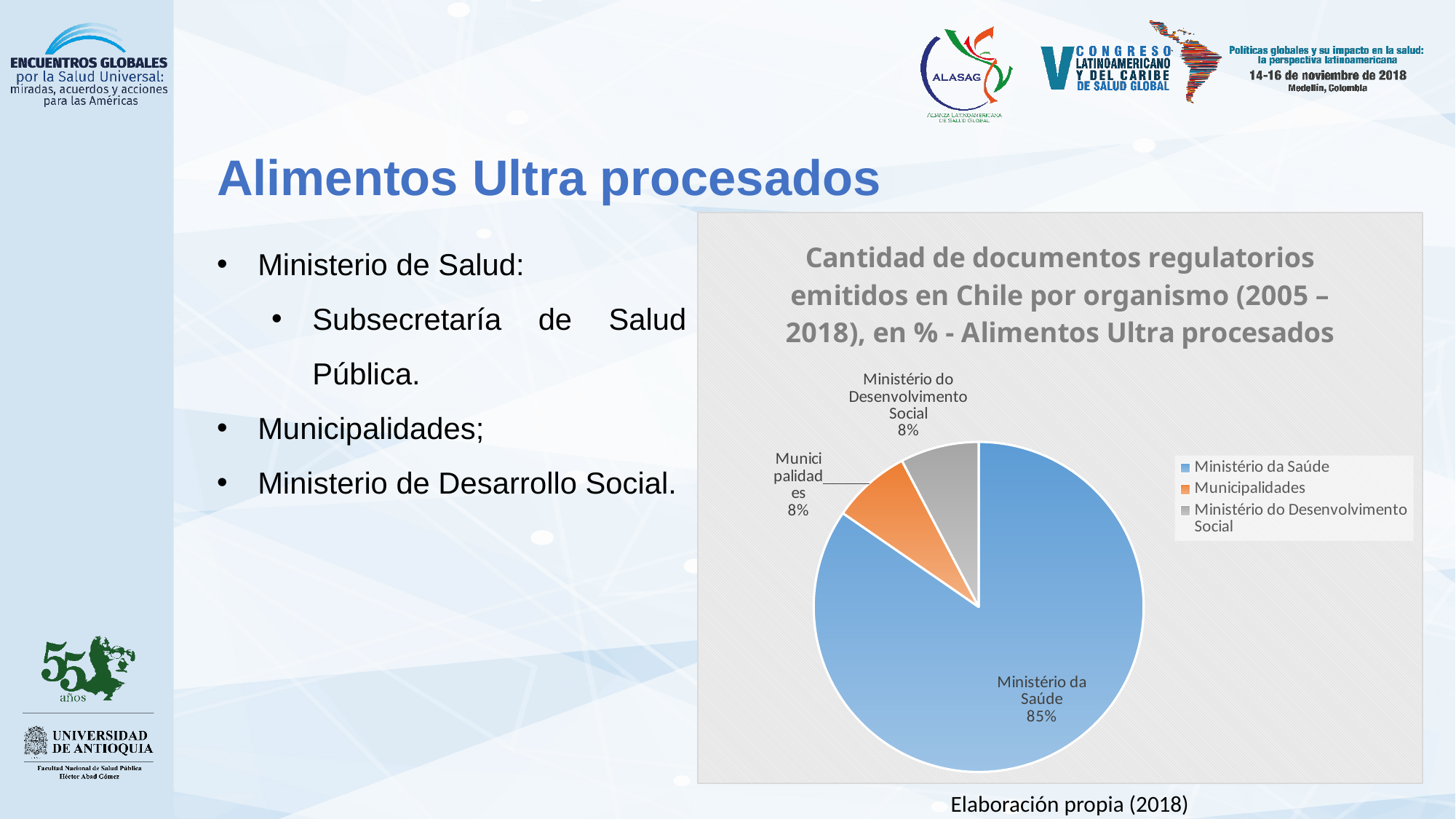
What colour is the Municipalidades slice in the pie chart? Orange What share of the pie does Ministério da Saúde have? 85% What is the difference in percentage points between the Ministério da Saúde slice and the Municipalidades slice? 77 What share of the pie does Municipalidades have? 8% What kind of chart is shown on the slide? Pie chart Which category has the largest slice of the pie? Ministério da Saúde What share of the pie does Ministério do Desenvolvimento Social have? 8% How many slices does the pie chart have? 3 Which is larger, the slice for Ministério da Saúde or the slice for Ministério do Desenvolvimento Social? Ministério da Saúde How many entries does the legend list? 3 What is the title of the chart? Cantidad de documentos regulatorios emitidos en Chile por organismo (2005 – 2018), en % - Alimentos Ultra procesados